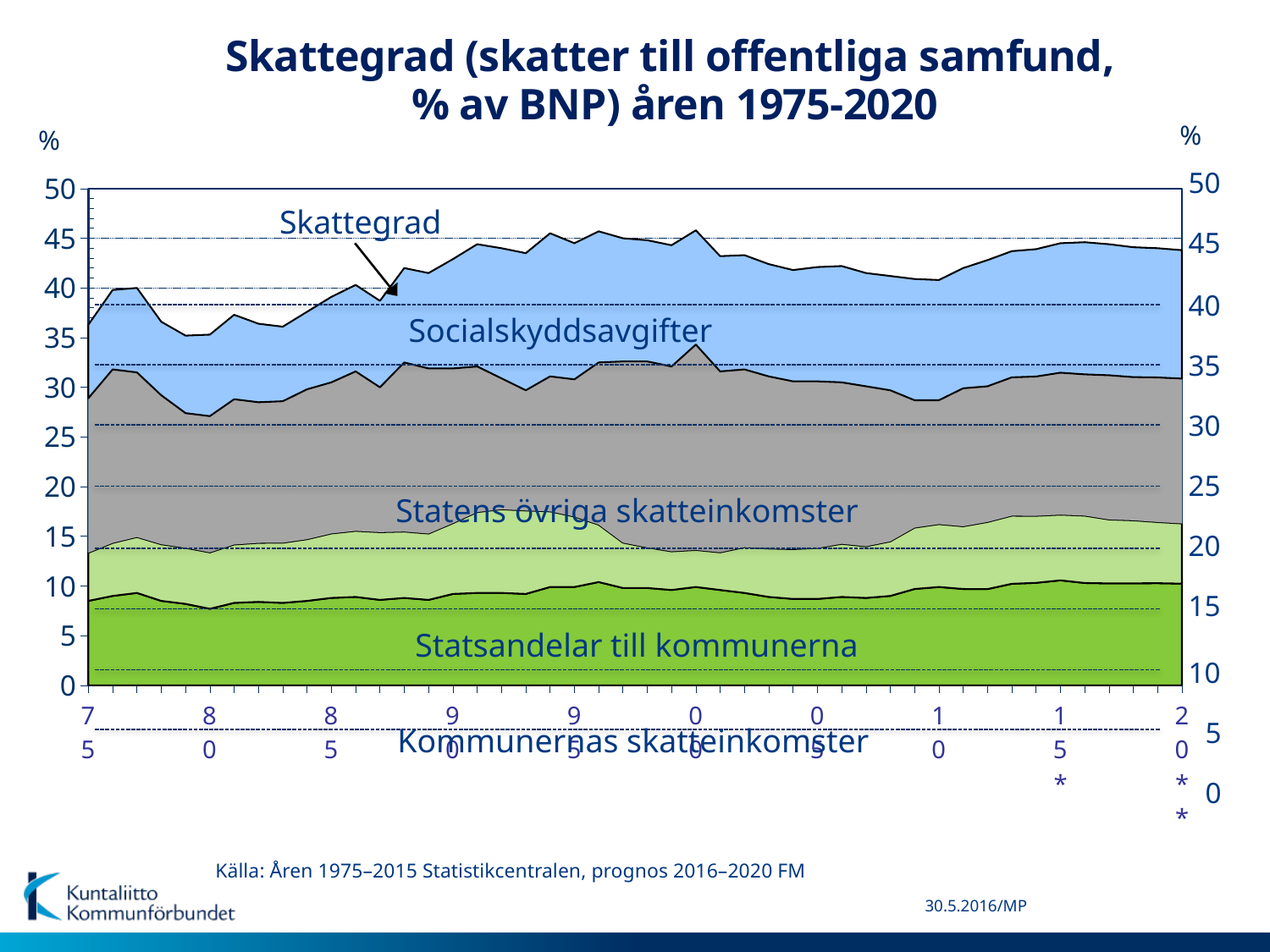
Is the Skattegrad value higher in 1990 or in 1975? 1990 What kind of chart is shown on the slide? Stacked area chart Is the Skattegrad value higher in 2020 or in 1975? 2020 What unit is shown on the vertical axis of the chart? % Is the Skattegrad value in 1975 greater or less than 30? greater Is the Skattegrad value in 2020 greater or less than 40? greater Does the Skattegrad line rise or fall between 1975 and 1990? rise What is the title of the chart? Skattegrad (skatter till offentliga samfund, % av BNP) åren 1975-2020 Which years does the chart cover according to its title? 1975-2020 What is the highest value shown on the vertical axis of the chart? 50 Which series label is shown in the top blue area of the chart? Socialskyddsavgifter Is the Skattegrad value in 1975 greater or less than 40? less